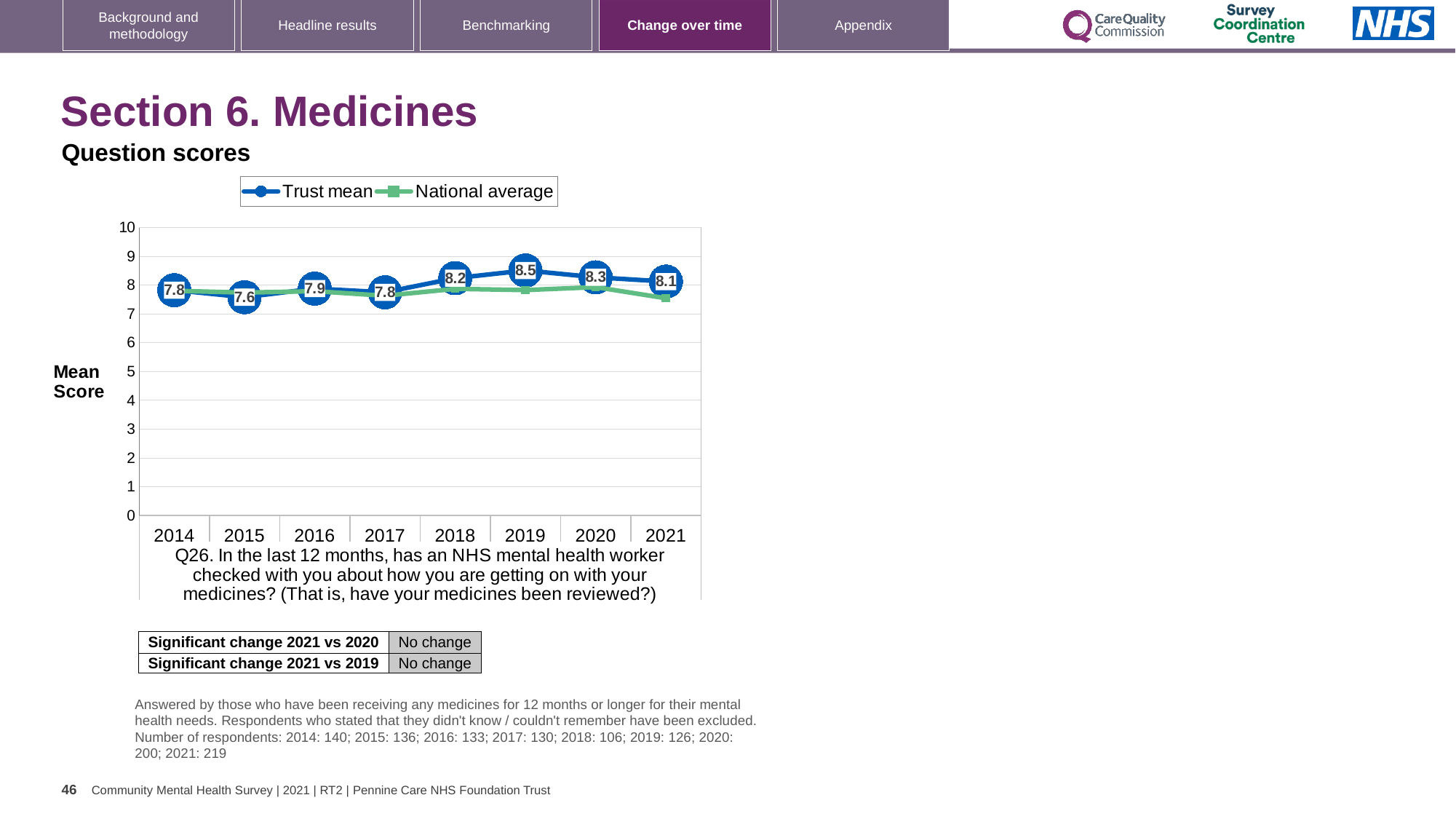
What is the Trust mean score for 2019? 8.5 Which is larger, the Trust mean score for 2018 or for 2020? 2020 In which year is the Trust mean score highest? 2019 What is the Trust mean score for 2021? 8.1 Does the Trust mean score rise or fall from 2019 to 2021? fall How many years are shown on the x axis of the chart? 8 How many series does the chart legend list? 2 What is the Trust mean score for 2015? 7.6 What kind of chart is shown on the slide? line chart What is the difference between the Trust mean scores for 2019 and 2015? 0.9 Is the National average value for 2021 greater or less than 8? less In which year is the Trust mean score lowest? 2015